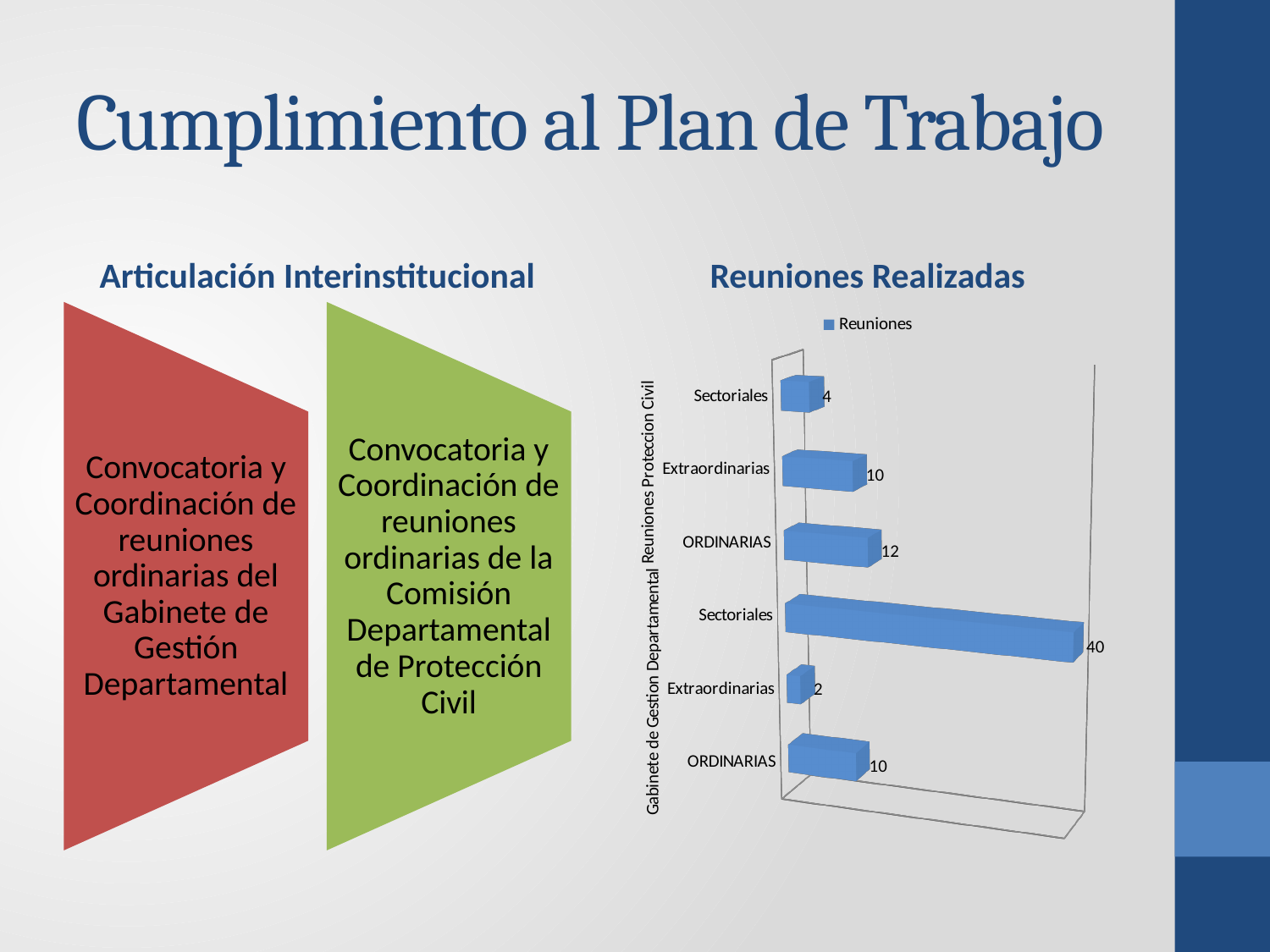
Which bar has the highest value in the "Reuniones Realizadas" chart? Sectoriales (Gabinete de Gestion Departamental) Which bar has the lowest value in the "Reuniones Realizadas" chart? Extraordinarias (Gabinete de Gestion Departamental) In the "Reuniones Realizadas" chart, what is the value for ORDINARIAS under Reuniones Proteccion Civil? 12 How many bars are plotted in the "Reuniones Realizadas" chart? 6 In the "Reuniones Realizadas" chart, what is the value for Sectoriales under Reuniones Proteccion Civil? 4 How many series does the legend of the "Reuniones Realizadas" chart list? 1 What is the name of the series in the legend of the "Reuniones Realizadas" chart? Reuniones In the "Reuniones Realizadas" chart, which is larger: ORDINARIAS under Reuniones Proteccion Civil or ORDINARIAS under Gabinete de Gestion Departamental? ORDINARIAS under Reuniones Proteccion Civil In the "Reuniones Realizadas" chart, what is the value for Extraordinarias under Gabinete de Gestion Departamental? 2 In the "Reuniones Realizadas" chart, what is the difference between Sectoriales under Gabinete de Gestion Departamental and ORDINARIAS under Reuniones Proteccion Civil? 28 What kind of chart is shown under "Reuniones Realizadas"? bar chart In the "Reuniones Realizadas" chart, what is the value for Sectoriales under Gabinete de Gestion Departamental? 40